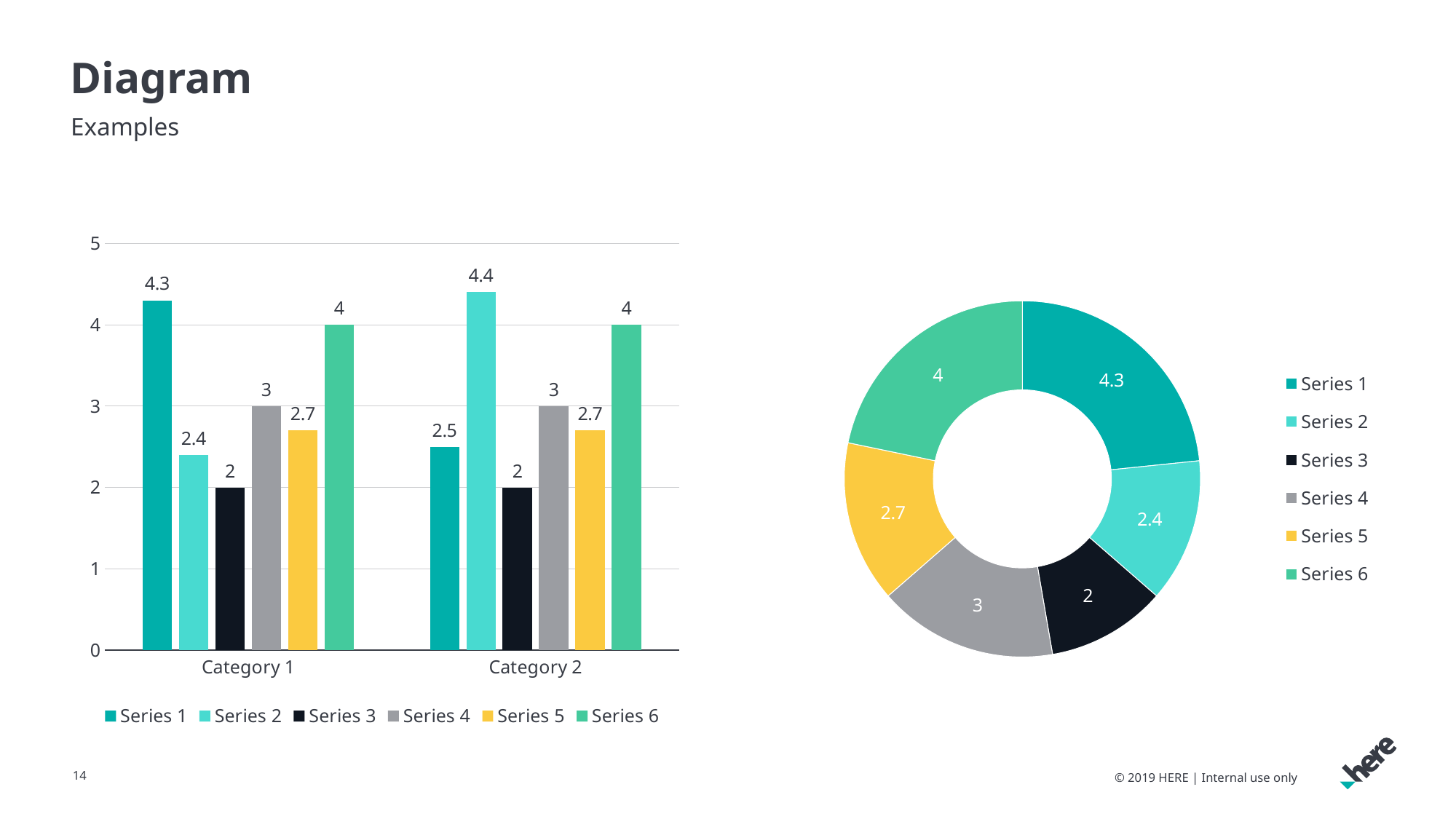
In the doughnut chart on the right, what is the value of Series 5? 2.7 How many series does the legend of the bar chart on the left list? 6 How many categories are shown on the x axis of the bar chart on the left? 2 In the doughnut chart on the right, what is the difference between the values of Series 6 and Series 3? 2 In the bar chart on the left, which series has the highest value in Category 2? Series 2 In the bar chart on the left, which series has the lowest value in Category 1? Series 3 In the bar chart on the left, what is the difference between Series 1 in Category 1 and Series 1 in Category 2? 1.8 In the doughnut chart on the right, which series has the largest slice? Series 1 What type of chart is shown on the left of the slide? Bar chart In the bar chart on the left, what is the value of Series 2 for Category 2? 4.4 In the bar chart on the left, what is the value of Series 1 for Category 1? 4.3 In the bar chart on the left, is Series 6 or Series 4 larger in Category 1? Series 6